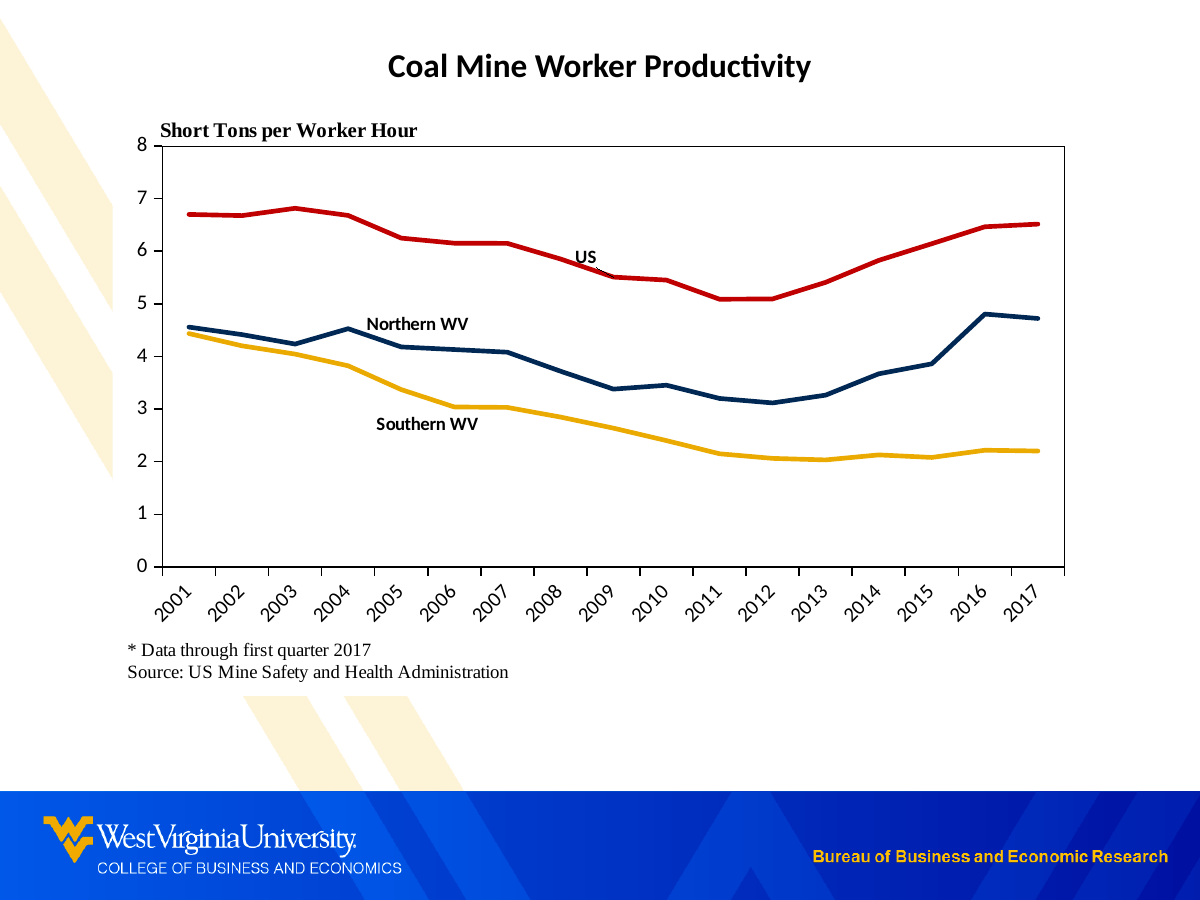
Which series has the highest value in 2010? US What unit is given for the y axis? Short Tons per Worker Hour What kind of chart is shown on the slide? line chart Is the value for Northern WV in 2016 greater or less than 4? greater Does the Southern WV line rise or fall from 2001 to 2012? fall How many years are shown along the x axis? 17 Which series has the lowest value in 2017? Southern WV Is the value for US in 2001 greater or less than 6? greater Is the value for Southern WV in 2012 greater or less than 3? less In 2005, which is larger: Northern WV or Southern WV? Northern WV How many series are plotted on the chart? 3